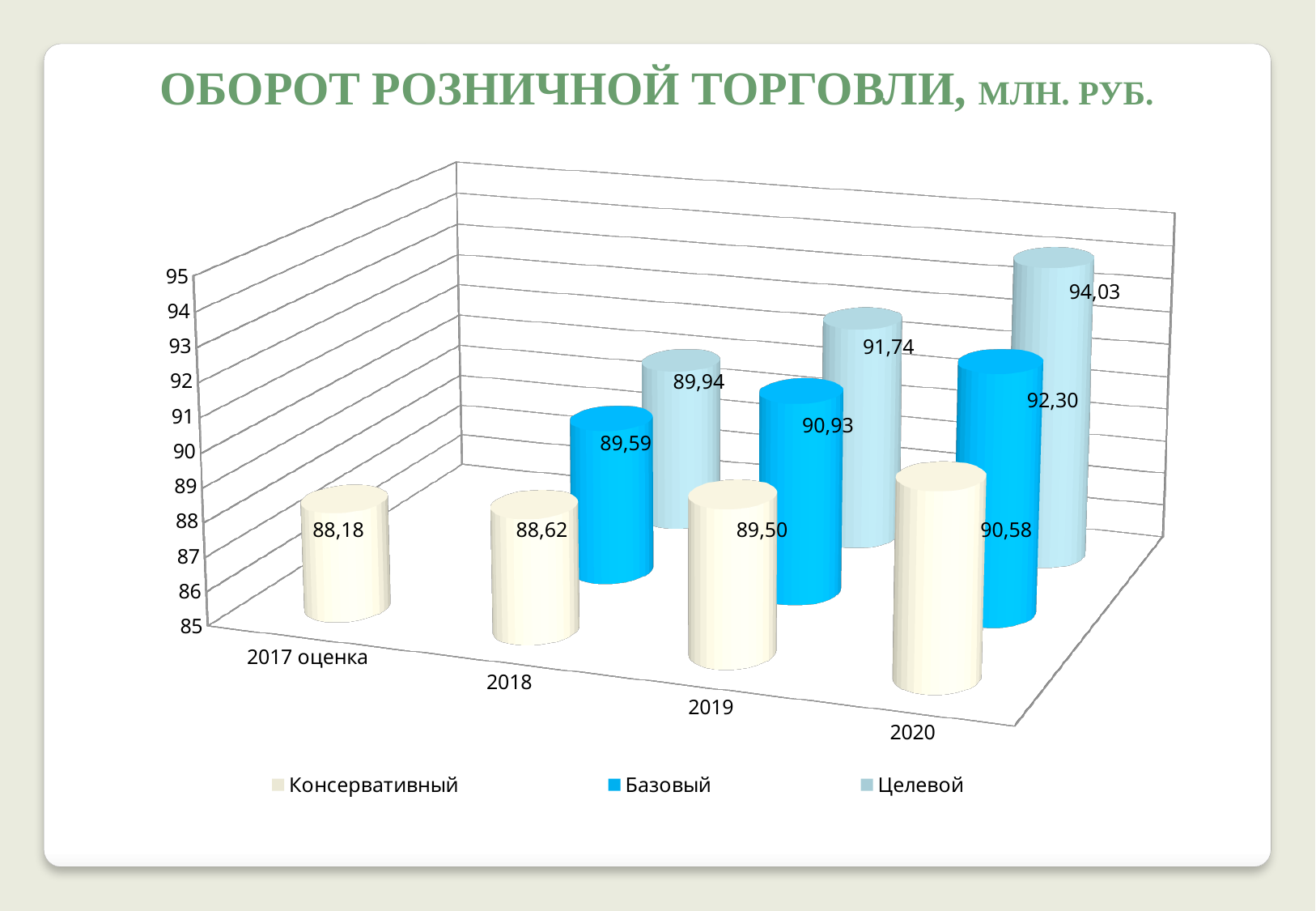
What is the value for Целевой in 2020? 94,03 Which category has the lowest value for the Консервативный series? 2017 оценка What is the value for Базовый in 2019? 90,93 How many series does the legend list? 3 What is the difference between the Консервативный values for 2020 and 2017 оценка? 2,40 Which is larger in 2018: the Базовый value or the Целевой value? Целевой What kind of chart is shown on the slide? Bar chart Do the Консервативный values rise or fall from 2017 оценка to 2020? Rise What is the difference between the Целевой and Базовый values in 2020? 1,73 What is the value for Консервативный in 2020? 90,58 Which year has the highest value for the Целевой series? 2020 What is the value for Консервативный in 2017 оценка? 88,18